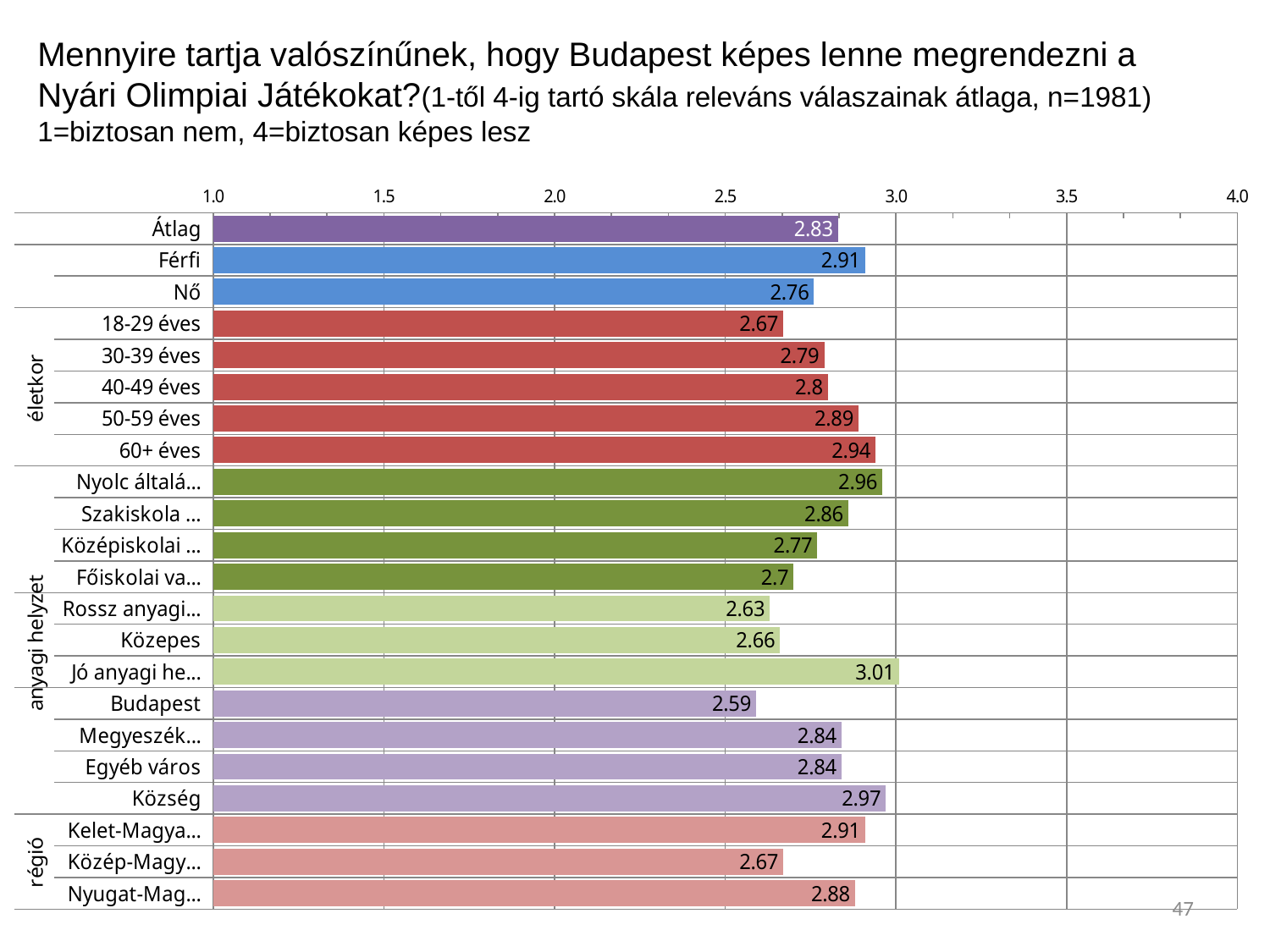
What kind of chart is shown on the slide? Bar chart Among the age groups (életkor), which category has the highest value? 60+ éves Which is larger, the value for Község or the value for Budapest? Község What is the difference between the values for Férfi and Nő? 0.15 What is the value for Nő? 2.76 What is the value for Átlag? 2.83 How many bars are plotted in the chart? 22 What is the difference between the values for Község and Budapest? 0.38 What is the value for Község? 2.97 What is the value for 60+ éves? 2.94 Which category has the lowest value in the chart? Budapest What is the value for Férfi? 2.91